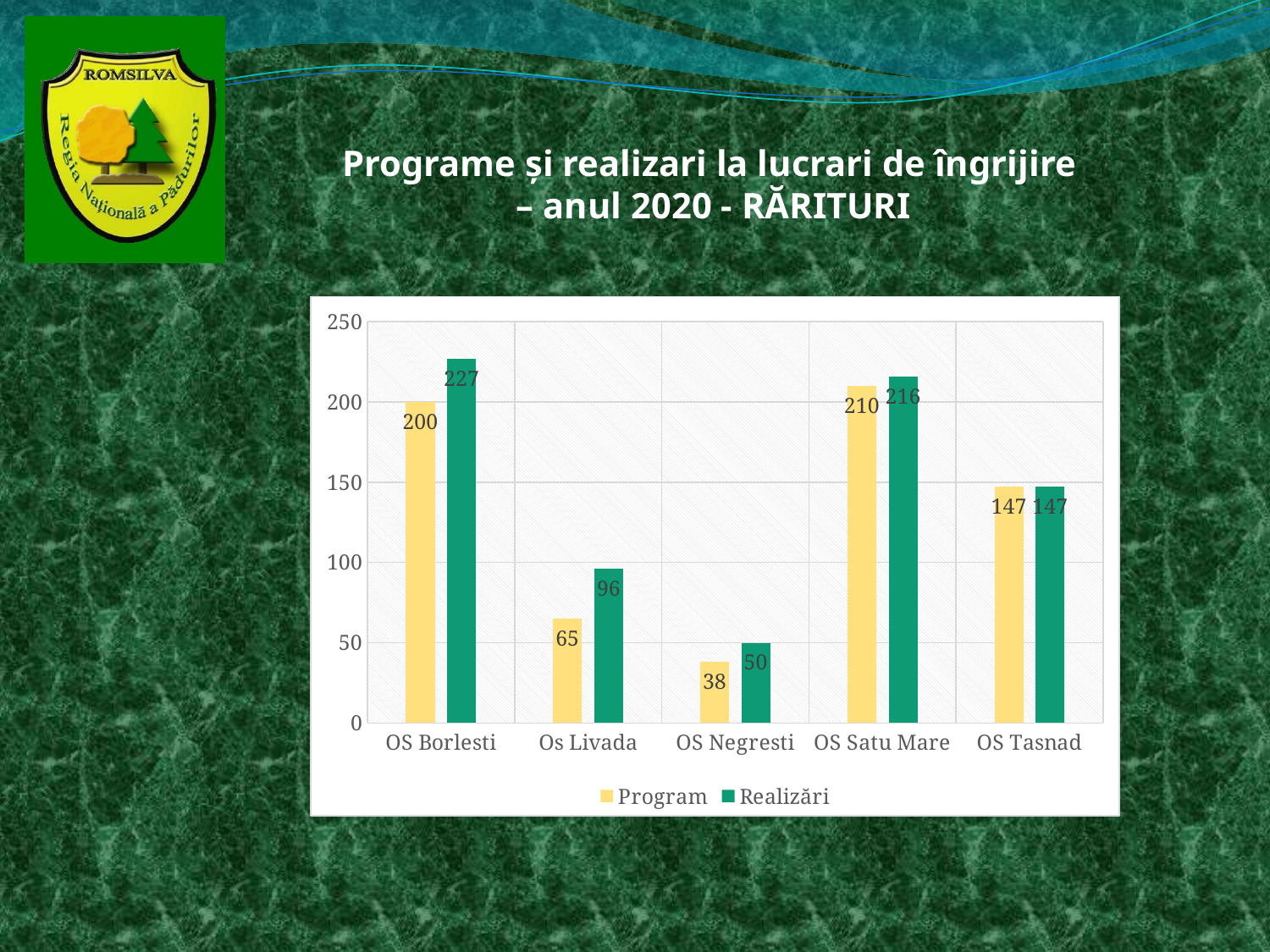
Which is larger for OS Satu Mare, the Program value or the Realizări value? Realizări How many series does the legend list? 2 How many categories are shown on the x axis? 5 What is the Program value for OS Negresti? 38 What is the difference between the Realizări and Program values for Os Livada? 31 What is the difference between the Realizări and Program values for OS Borlesti? 27 What colour are the Program bars? yellow Which category has the highest Realizări value? OS Borlesti Which category has the lowest Program value? OS Negresti What is the Program value for OS Borlesti? 200 What kind of chart is shown on the slide? bar chart What is the Realizări value for Os Livada? 96